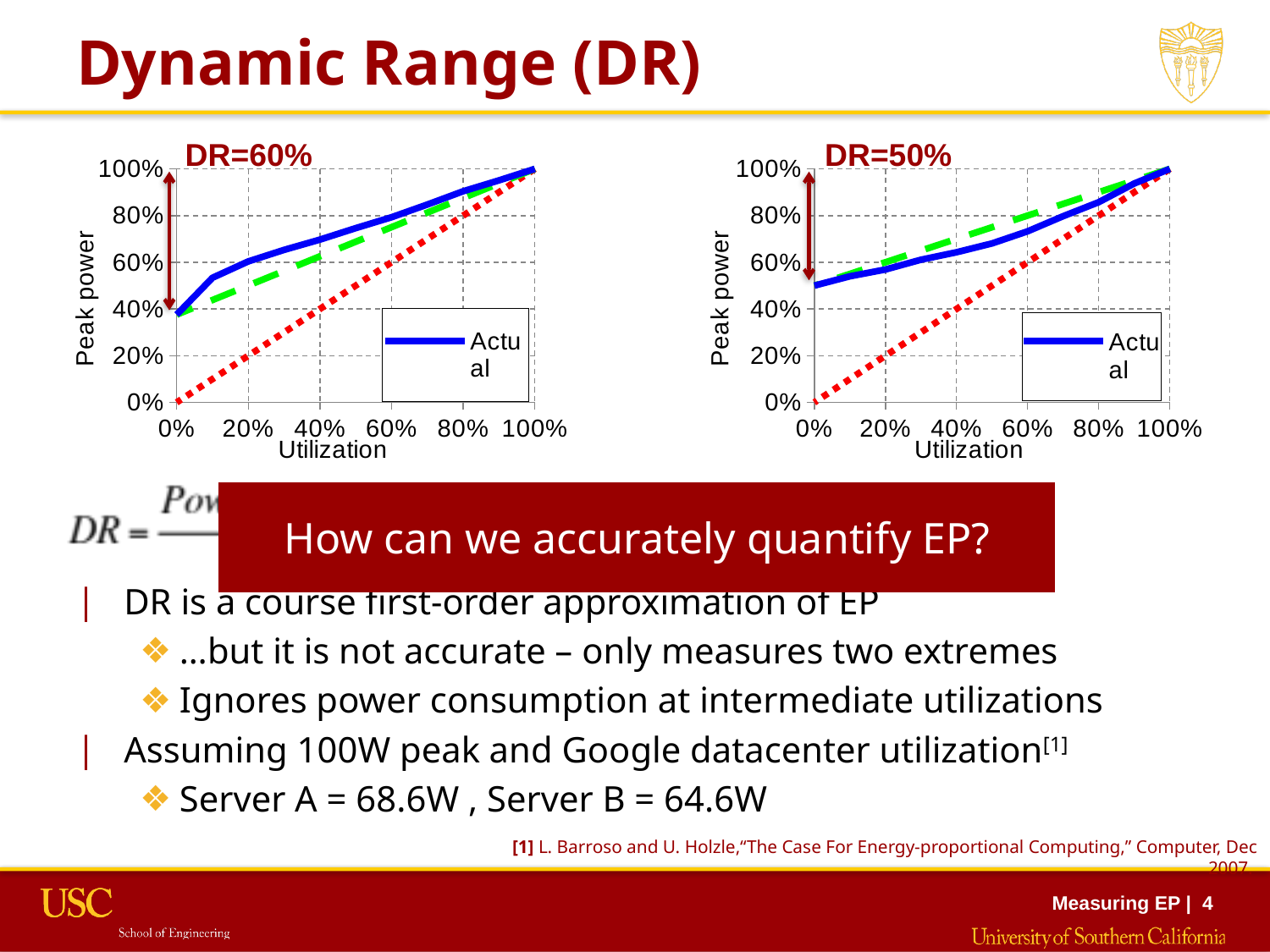
In the right chart (DR=50%), is the Actual peak power at 60% utilization greater or less than 80%? less In the right chart (DR=50%), what is the Actual peak power at 100% utilization? 100% What series name is shown in the legend of the left chart (DR=60%)? Actual What is the label on the x axis of the right chart (DR=50%)? Utilization In the left chart (DR=60%), does the Actual peak power rise or fall as utilization increases? Rises What kind of chart is the left chart labelled DR=60%? Line chart Which chart shows the higher Actual peak power at 0% utilization, the left chart (DR=60%) or the right chart (DR=50%)? The right chart (DR=50%) In the left chart (DR=60%), what is the Actual peak power at 100% utilization? 100% In the left chart (DR=60%), is the Actual peak power at 40% utilization greater or less than 60%? greater